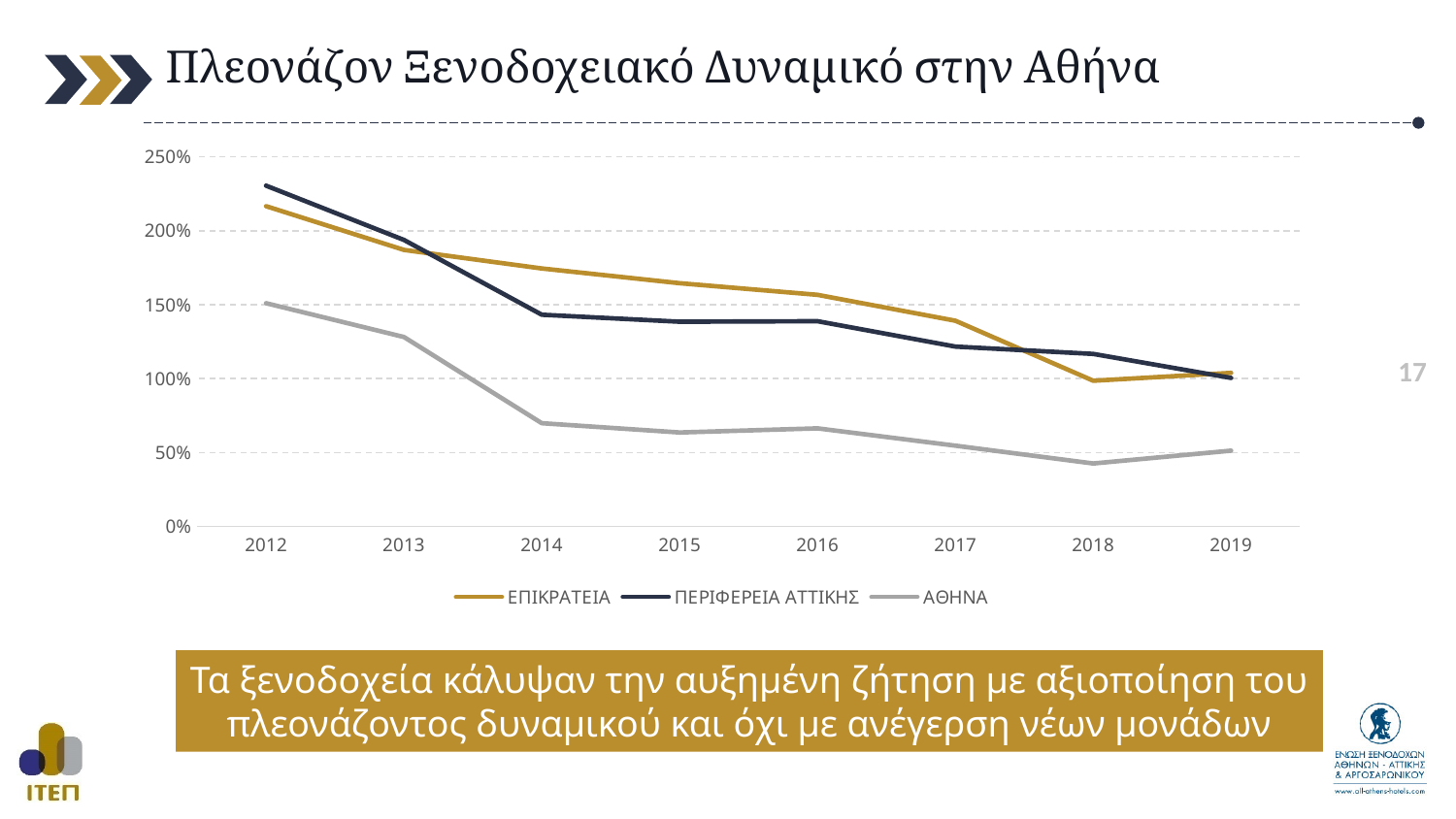
How many years are shown on the x axis? 8 Which series has the lowest values across all years? ΑΘΗΝΑ Which series has the highest value in 2012? ΠΕΡΙΦΕΡΕΙΑ ΑΤΤΙΚΗΣ Does the ΑΘΗΝΑ series generally rise or fall from 2012 to 2019? Fall In 2018, which is larger: ΠΕΡΙΦΕΡΕΙΑ ΑΤΤΙΚΗΣ or ΕΠΙΚΡΑΤΕΙΑ? ΠΕΡΙΦΕΡΕΙΑ ΑΤΤΙΚΗΣ Is the value for ΕΠΙΚΡΑΤΕΙΑ in 2016 greater or less than 150%? greater In which year does the ΑΘΗΝΑ series reach its lowest value? 2018 What colour is the line for ΑΘΗΝΑ? Grey Is the value for ΑΘΗΝΑ in 2014 greater or less than 100%? less What kind of chart is shown on the slide? Line chart Is the value for ΠΕΡΙΦΕΡΕΙΑ ΑΤΤΙΚΗΣ in 2012 greater or less than 200%? greater How many series does the legend list? 3